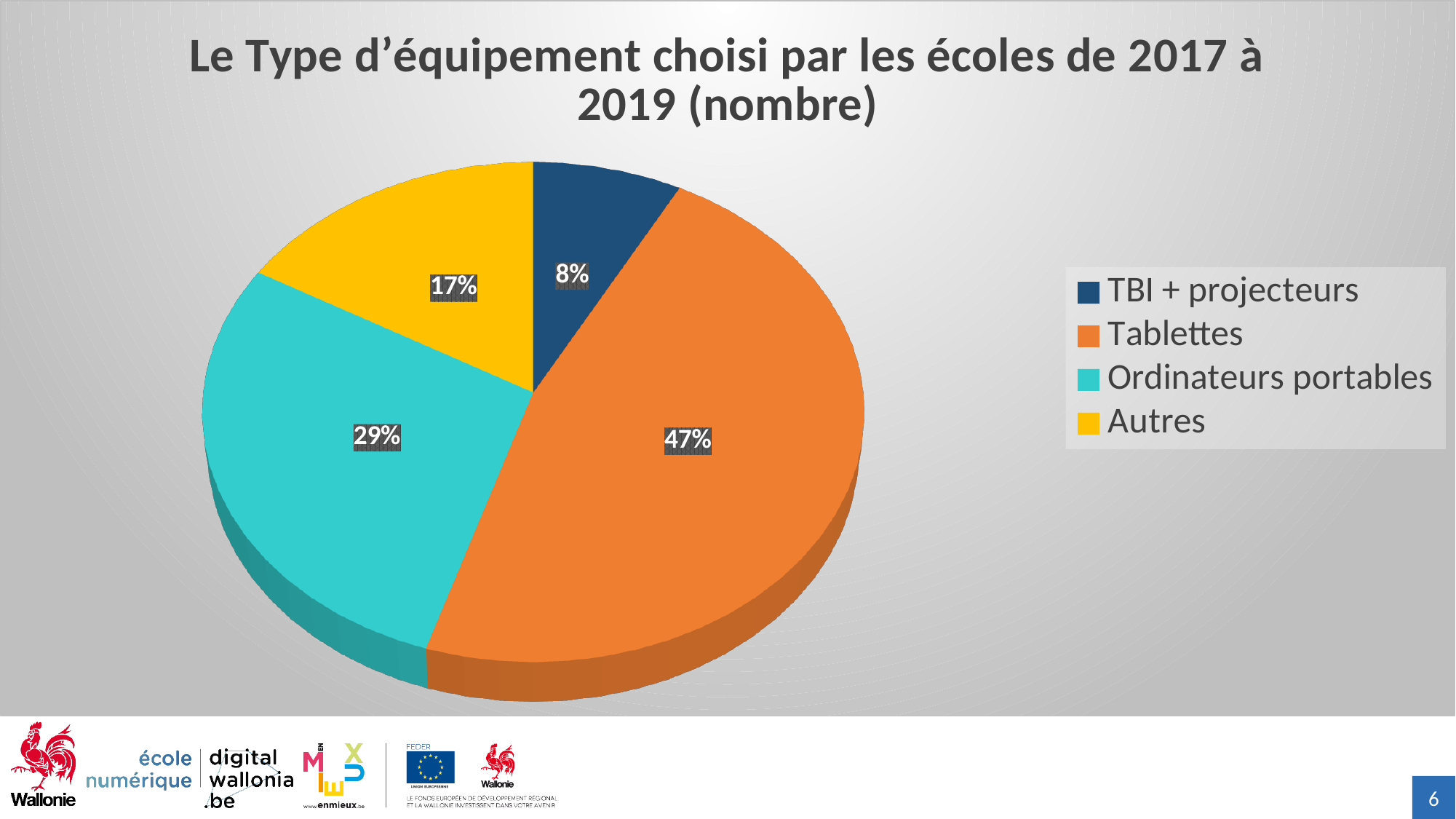
What share of the pie does Autres represent? 17% Which category has the largest slice of the pie? Tablettes What is the difference in percentage points between Tablettes and Ordinateurs portables? 18 What is the title of the chart? Le Type d’équipement choisi par les écoles de 2017 à 2019 (nombre) What share of the pie does TBI + projecteurs represent? 8% Which category has the smallest slice of the pie? TBI + projecteurs What share of the pie does Tablettes represent? 47% What colour is the slice for Ordinateurs portables? turquoise Which is larger, the share for Autres or the share for TBI + projecteurs? Autres What type of chart is shown on the slide? pie chart How many categories does the pie chart show? 4